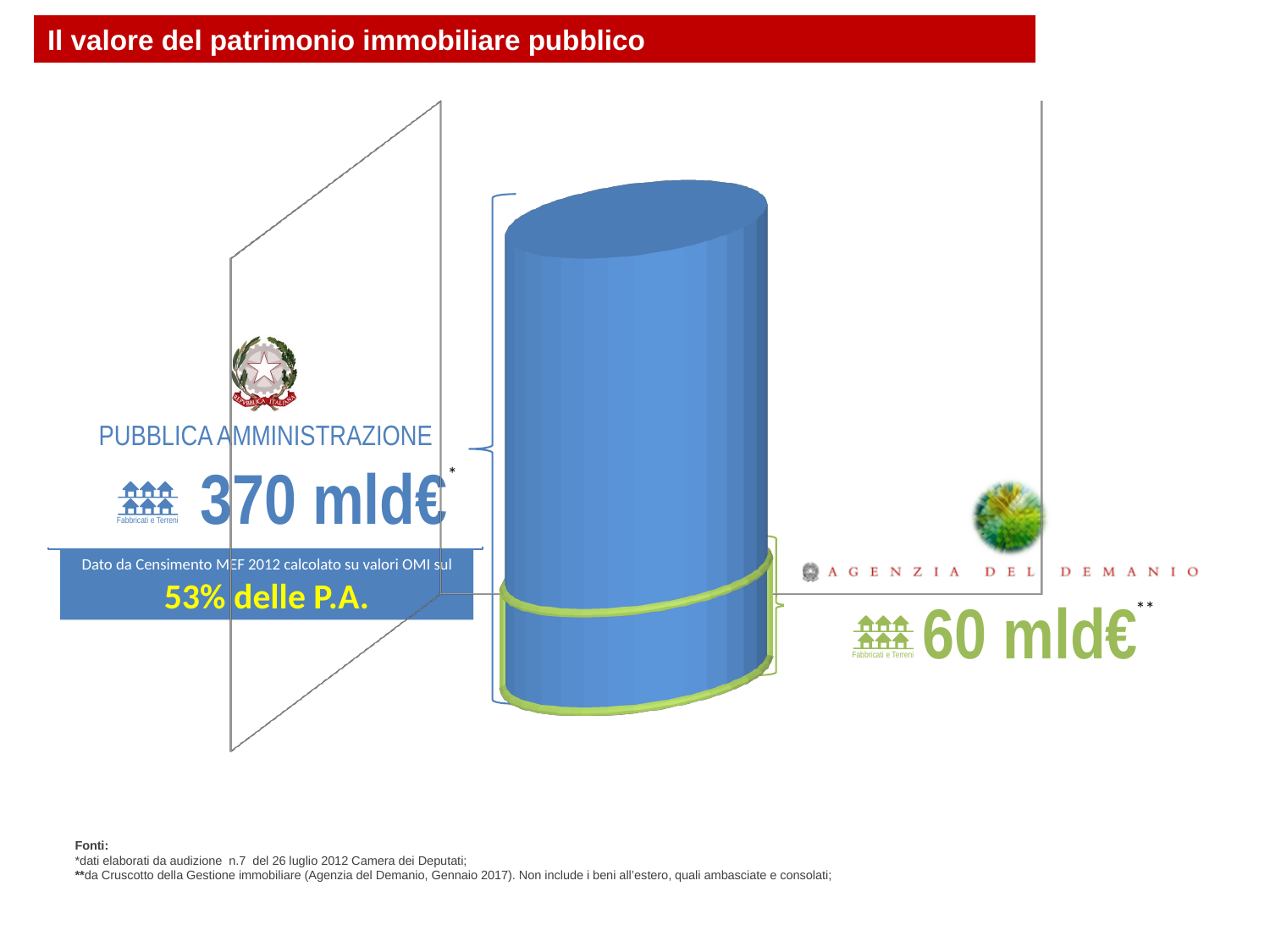
Which is larger, the value for Pubblica Amministrazione or the value for Agenzia del Demanio? Pubblica Amministrazione What value is shown for Agenzia del Demanio on the slide? 60 mld€ What is the difference between the Pubblica Amministrazione value (370 mld€) and the Agenzia del Demanio value (60 mld€)? 310 mld€ What percentage of the P.A. is the 370 mld€ figure stated to be calculated on? 53% Which of the two values shown on the cylinder is the smallest? Agenzia del Demanio (60 mld€) What is the title of the slide containing the cylinder graphic? Il valore del patrimonio immobiliare pubblico What colour is the band on the cylinder that marks the Agenzia del Demanio portion? Green What value is shown for Pubblica Amministrazione on the slide? 370 mld€ How many values are labelled on the cylinder graphic? 2 Which of the two values shown on the cylinder is the highest? Pubblica Amministrazione (370 mld€)